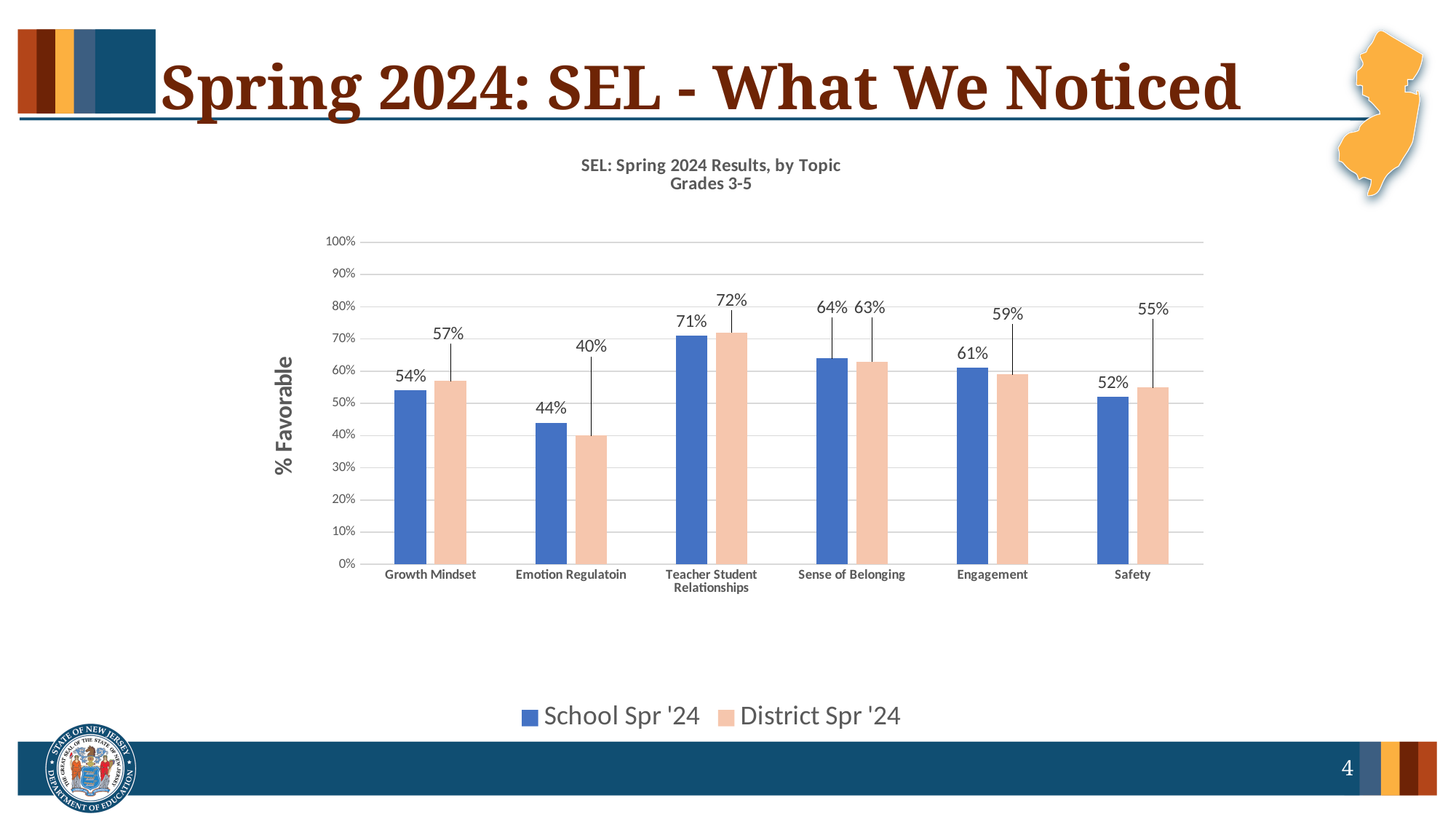
Which topic has the highest School Spr '24 value? Teacher Student Relationships What is the District Spr '24 value for Emotion Regulatoin? 40% Which topic has the lowest District Spr '24 value? Emotion Regulatoin What is the School Spr '24 value for Growth Mindset? 54% For Growth Mindset, which is larger: the School Spr '24 value or the District Spr '24 value? District Spr '24 What is the School Spr '24 value for Teacher Student Relationships? 71% What kind of chart is shown on the slide? Bar chart How many topics are shown on the x axis? 6 How many series does the legend list? 2 What is the District Spr '24 value for Safety? 55% What is the label on the vertical axis? % Favorable What is the difference between the School Spr '24 and District Spr '24 values for Emotion Regulatoin? 4%